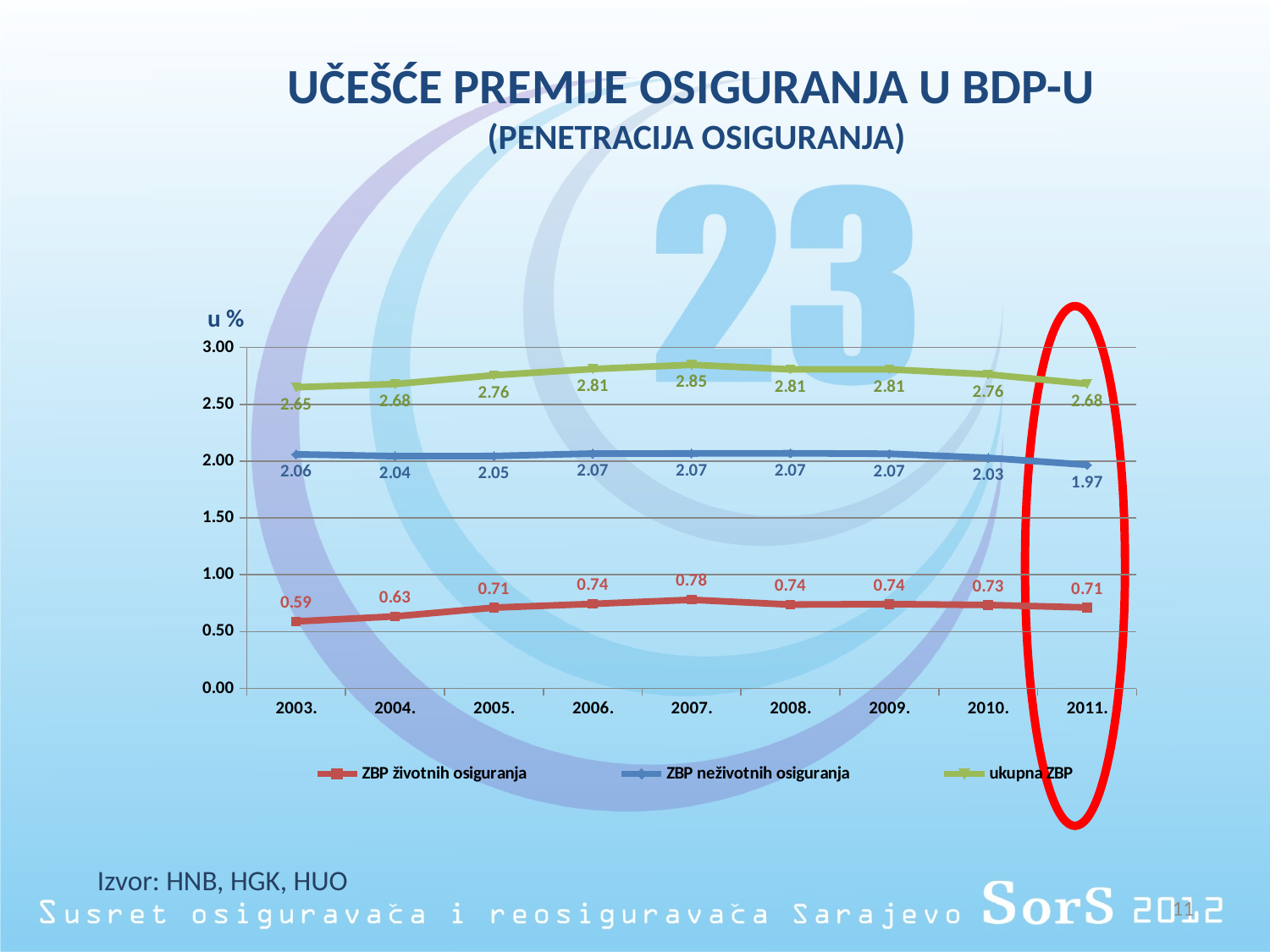
What is the value of ZBP neživotnih osiguranja in 2011.? 1.97 What unit label is shown above the y axis? u % In which year is ZBP neživotnih osiguranja lowest? 2011. What is the value of ukupna ZBP in 2007.? 2.85 What is the value of ZBP životnih osiguranja in 2003.? 0.59 How many years are plotted on the x axis? 9 Does ukupna ZBP rise or fall from 2007. to 2011.? fall In which year is ZBP životnih osiguranja highest? 2007. Which is larger: ZBP životnih osiguranja in 2005. or in 2011.? they are equal (0.71) What is the difference between ukupna ZBP in 2007. and in 2011.? 0.17 What type of chart is shown on the slide? line chart How many series does the legend list? 3